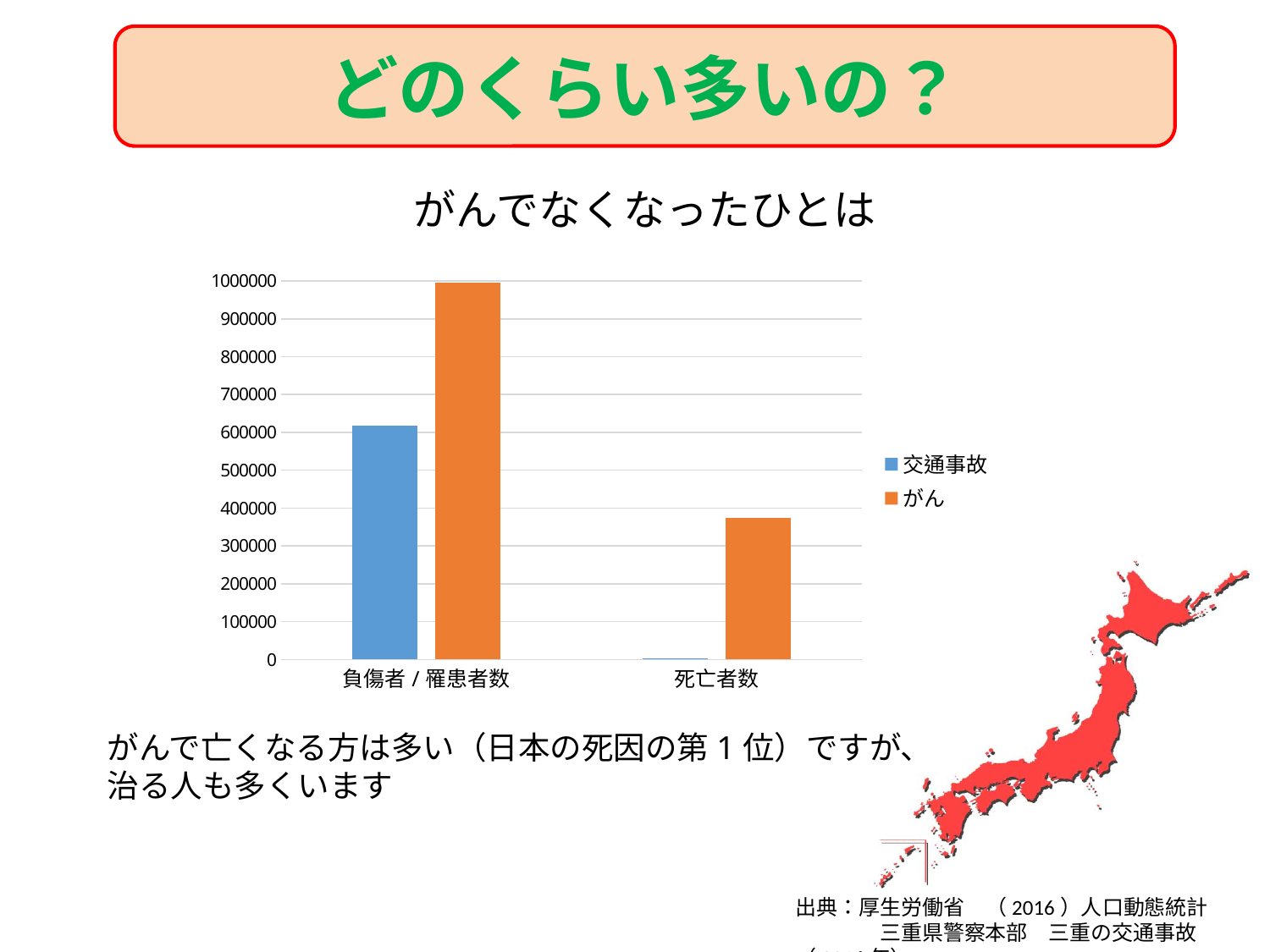
Which series has the highest bar in the chart? がん Is the value for 交通事故 in 負傷者／罹患者数 greater or less than 500000? greater What is the title of the chart? がんでなくなったひとは What kind of chart is shown on the slide? bar chart How many series does the legend list? 2 For 負傷者／罹患者数, which series has the larger value, 交通事故 or がん? がん Which colour represents the 交通事故 series in the chart? blue Which bar is the lowest in the chart? 交通事故 for 死亡者数 Is the value for がん in 死亡者数 greater or less than 400000? less Is the value for がん in 負傷者／罹患者数 greater or less than 900000? greater For 死亡者数, which series has the larger value, 交通事故 or がん? がん How many categories are shown on the x axis? 2